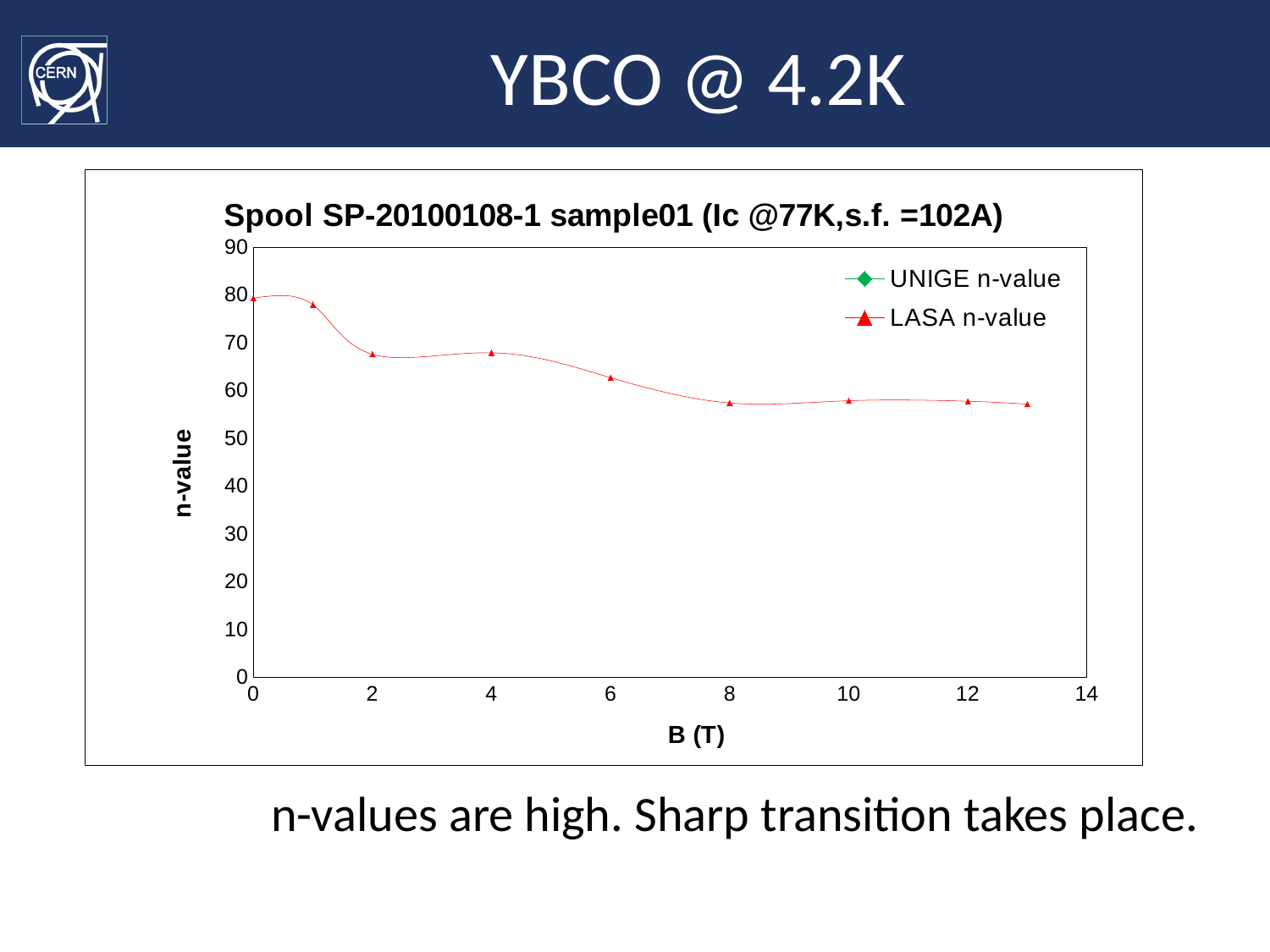
Which is larger, the LASA n-value at B = 1 T or at B = 6 T? B = 1 T How many data points are plotted for the LASA n-value series? 9 Is the LASA n-value at B = 0 T greater or less than 70? greater What is the title of the chart? Spool SP-20100108-1 sample01 (Ic @77K,s.f. =102A) At which value of B (T) is the LASA n-value highest? 0 Do the LASA n-values rise or fall as B increases along the x axis? fall What is the label of the y axis? n-value How many series does the legend list? 2 Is the LASA n-value at B = 2 T greater or less than 70? less Is the LASA n-value at B = 6 T greater or less than 60? greater What kind of chart is shown on the slide? line chart